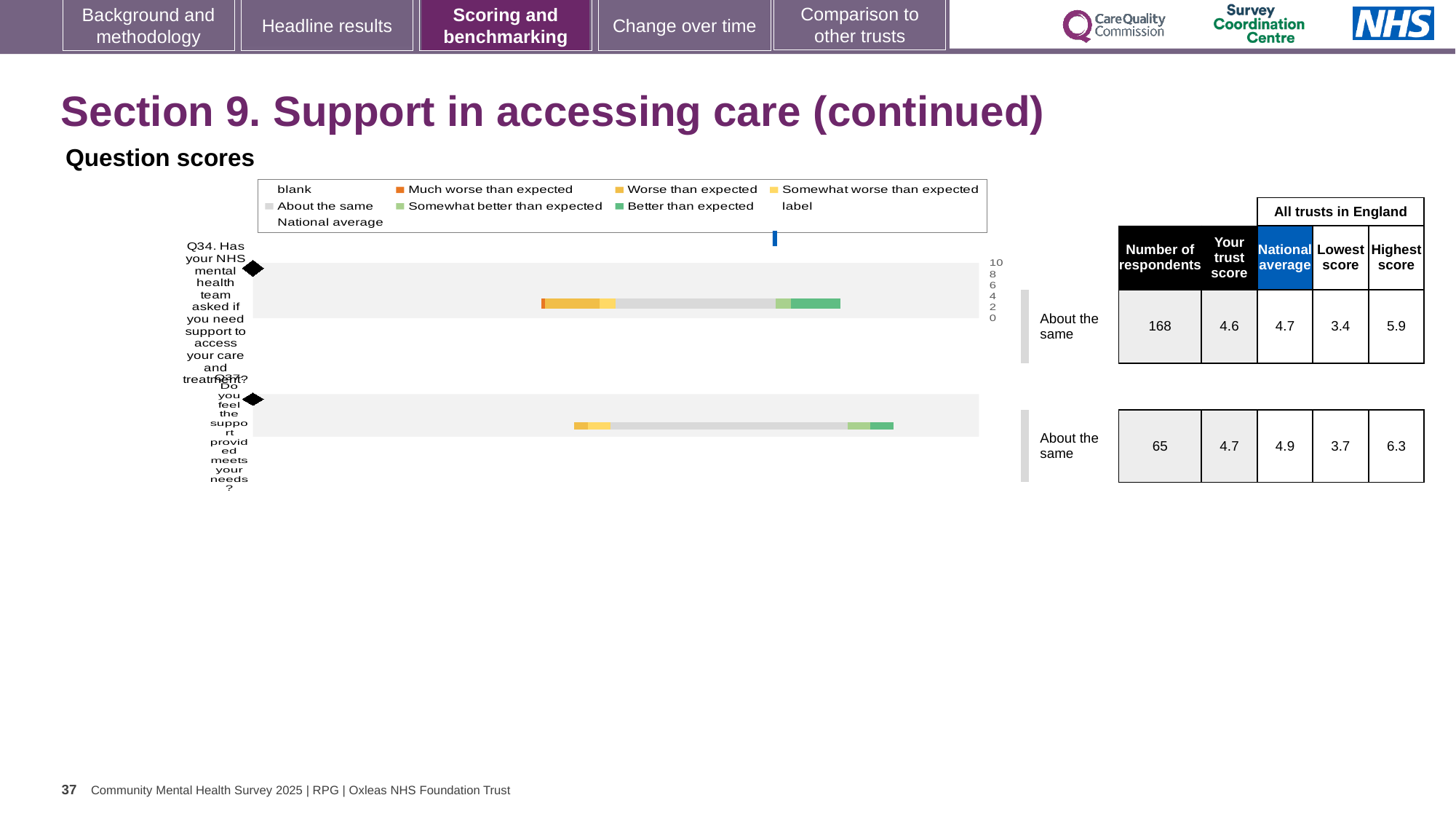
Which question has the higher trust score, Q34 or Q37? Q37 Which legend entry is shown in dark green in the question scores chart? Better than expected What is the lowest score across all trusts in England for Q34? 3.4 What benchmark category is given for Q34's trust score? About the same How many questions are plotted in the question scores chart? 2 How many respondents answered Q37? 65 What kind of chart is used to show the question scores on this slide? bar chart What is the national average for Q37 shown in the table next to the chart? 4.9 What is the highest score across all trusts in England for Q37? 6.3 What is the difference between the highest and lowest scores across all trusts in England for Q34? 2.5 What is the trust score for Q34 shown in the table next to the chart? 4.6 How many respondents answered Q34? 168